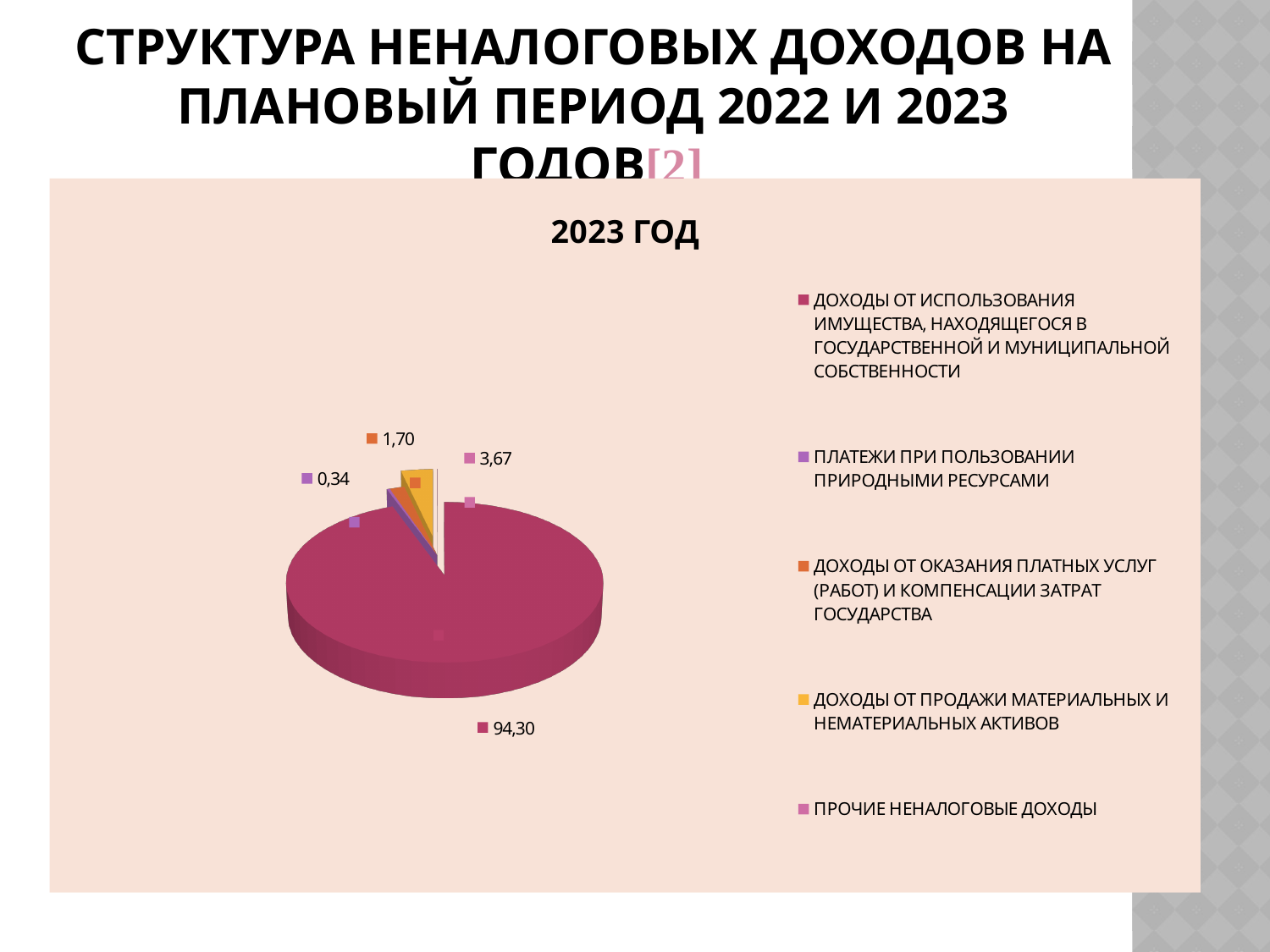
What is the difference between the value for ДОХОДЫ ОТ ИСПОЛЬЗОВАНИЯ ИМУЩЕСТВА and the value for ДОХОДЫ ОТ ОКАЗАНИЯ ПЛАТНЫХ УСЛУГ? 92,60 What is the smallest value labeled on the pie chart? 0,34 What is the largest value labeled on the pie chart? 94,30 Which is larger: the value for ДОХОДЫ ОТ ОКАЗАНИЯ ПЛАТНЫХ УСЛУГ or the value for ПЛАТЕЖИ ПРИ ПОЛЬЗОВАНИИ ПРИРОДНЫМИ РЕСУРСАМИ? ДОХОДЫ ОТ ОКАЗАНИЯ ПЛАТНЫХ УСЛУГ What type of chart is shown on the slide? pie chart What value is shown for ПЛАТЕЖИ ПРИ ПОЛЬЗОВАНИИ ПРИРОДНЫМИ РЕСУРСАМИ? 0,34 What value is shown for ДОХОДЫ ОТ ОКАЗАНИЯ ПЛАТНЫХ УСЛУГ (РАБОТ) И КОМПЕНСАЦИИ ЗАТРАТ ГОСУДАРСТВА? 1,70 What is the difference between the largest and smallest values labeled on the pie chart? 93,96 What is the title of the chart? 2023 ГОД How many categories does the chart legend list? 5 Which category has the largest slice of the pie? ДОХОДЫ ОТ ИСПОЛЬЗОВАНИЯ ИМУЩЕСТВА, НАХОДЯЩЕГОСЯ В ГОСУДАРСТВЕННОЙ И МУНИЦИПАЛЬНОЙ СОБСТВЕННОСТИ What value is shown for ДОХОДЫ ОТ ИСПОЛЬЗОВАНИЯ ИМУЩЕСТВА, НАХОДЯЩЕГОСЯ В ГОСУДАРСТВЕННОЙ И МУНИЦИПАЛЬНОЙ СОБСТВЕННОСТИ? 94,30